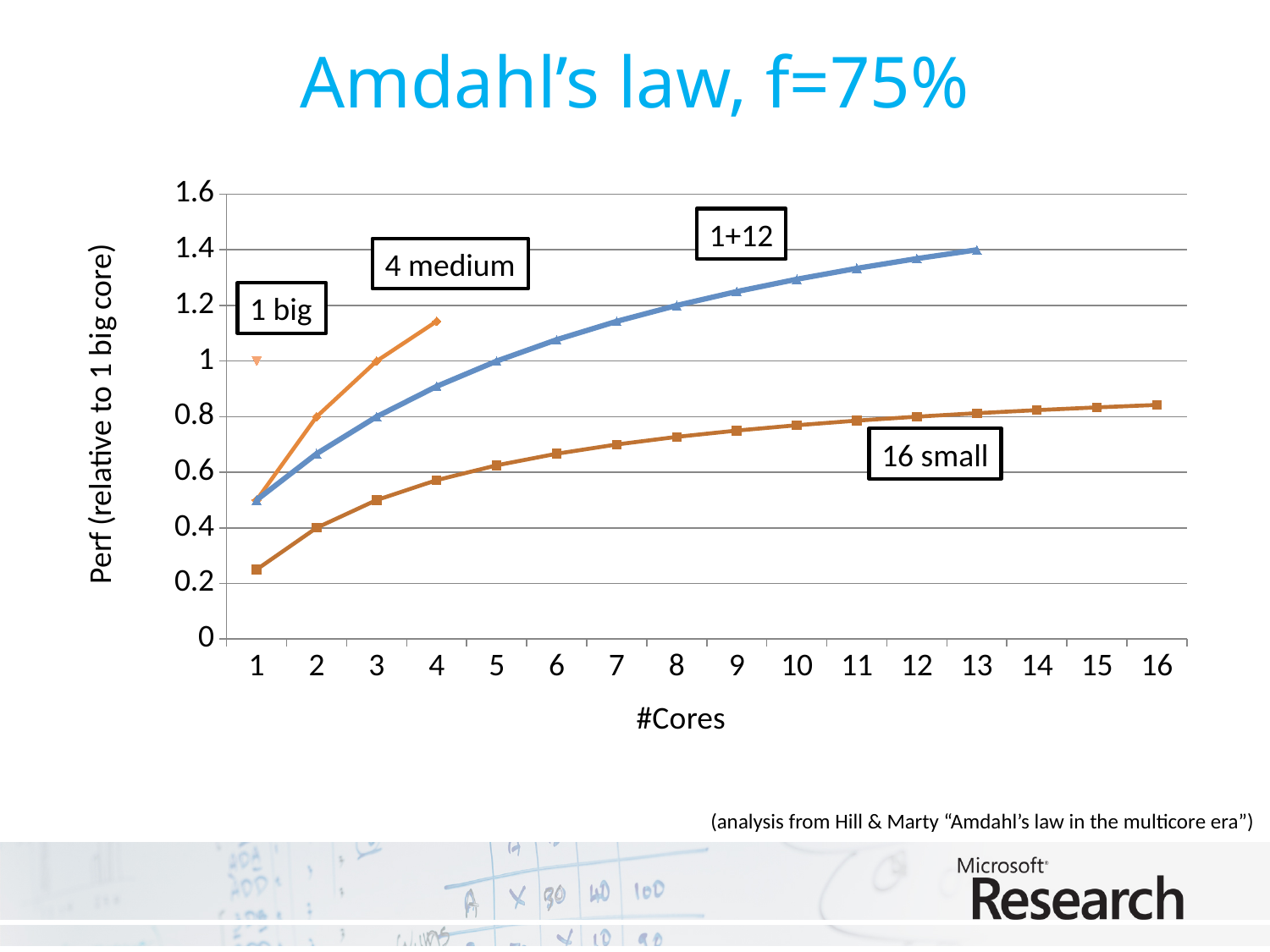
How many labelled series (lines) are plotted on the chart? 4 What kind of chart is shown on the slide? line chart What is the performance value of the '4 medium' line at 3 cores? 1 What is the title of the x axis? #Cores What is the performance value of the '1 big' point at 1 core? 1 What is the performance value of the '4 medium' line at 2 cores? 0.8 What is the performance value of the '16 small' line at 2 cores? 0.4 At 4 cores, which line has the higher performance value: '4 medium' or '1+12'? 4 medium Is the value for the '16 small' line at 16 cores greater or less than 1? less Is the value for the '1+12' line at 13 cores greater or less than 1.2? greater Does the '16 small' line rise or fall as the number of cores increases? rise Which series reaches the highest performance value on the chart? 1+12